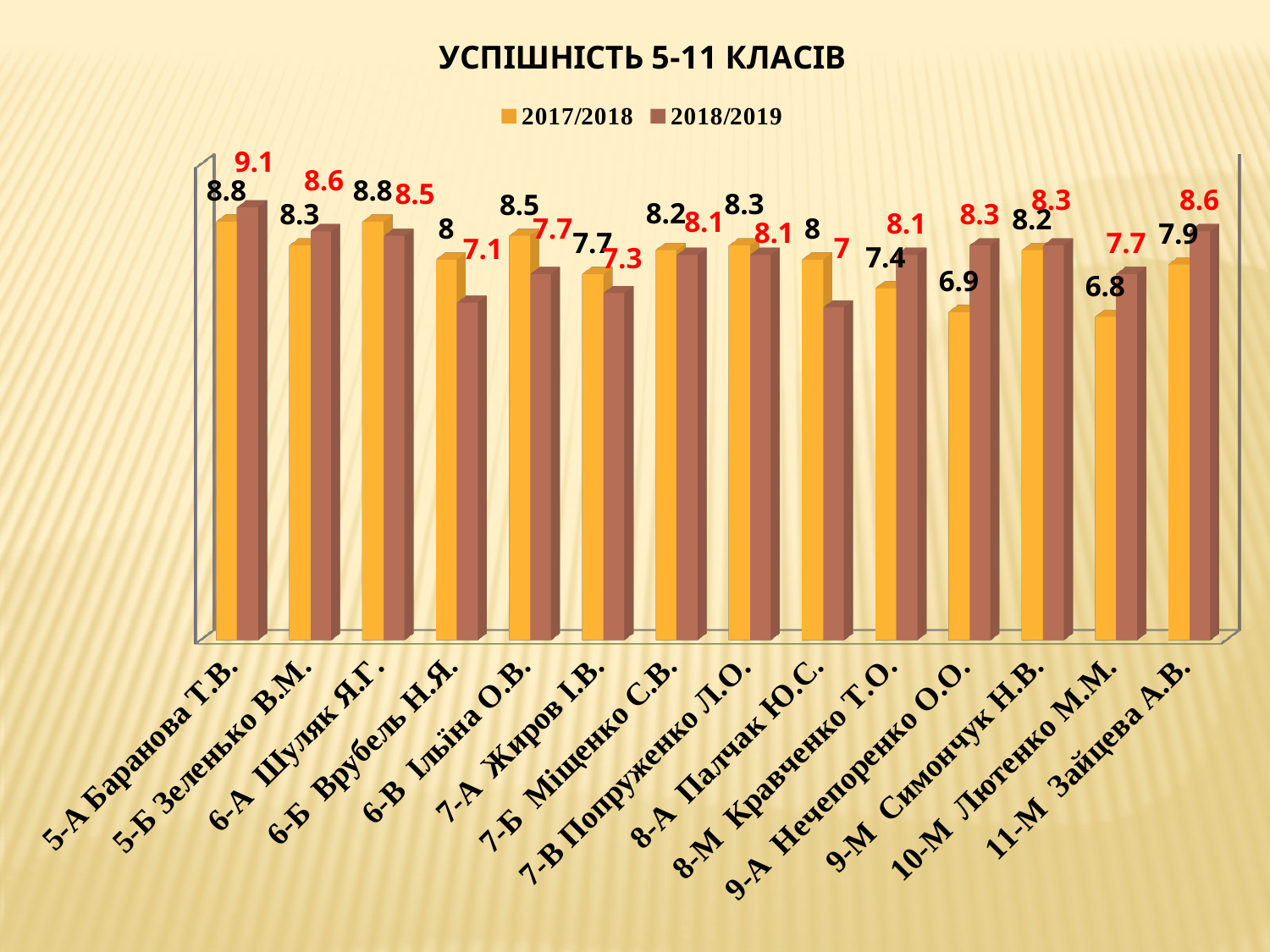
What is the difference between the 2018/2019 and 2017/2018 values for 9-А Нечепоренко О.О.? 1.4 What is the 2018/2019 value for 10-М Лютенко М.М.? 7.7 For 6-Б Врубель Н.Я., which is larger: the 2017/2018 value or the 2018/2019 value? 2017/2018 What is the 2018/2019 value for 5-А Баранова Т.В.? 9.1 What is the 2017/2018 value for 9-А Нечепоренко О.О.? 6.9 Which class has the lowest 2017/2018 value? 10-М Лютенко М.М. How many classes (categories) are shown on the x axis? 14 How many series does the legend list? 2 What type of chart is shown on the slide? bar chart Which class has the lowest 2018/2019 value? 8-А Палчак Ю.С. Which class has the highest 2018/2019 value? 5-А Баранова Т.В. What is the title of the chart? УСПІШНІСТЬ 5-11 КЛАСІВ